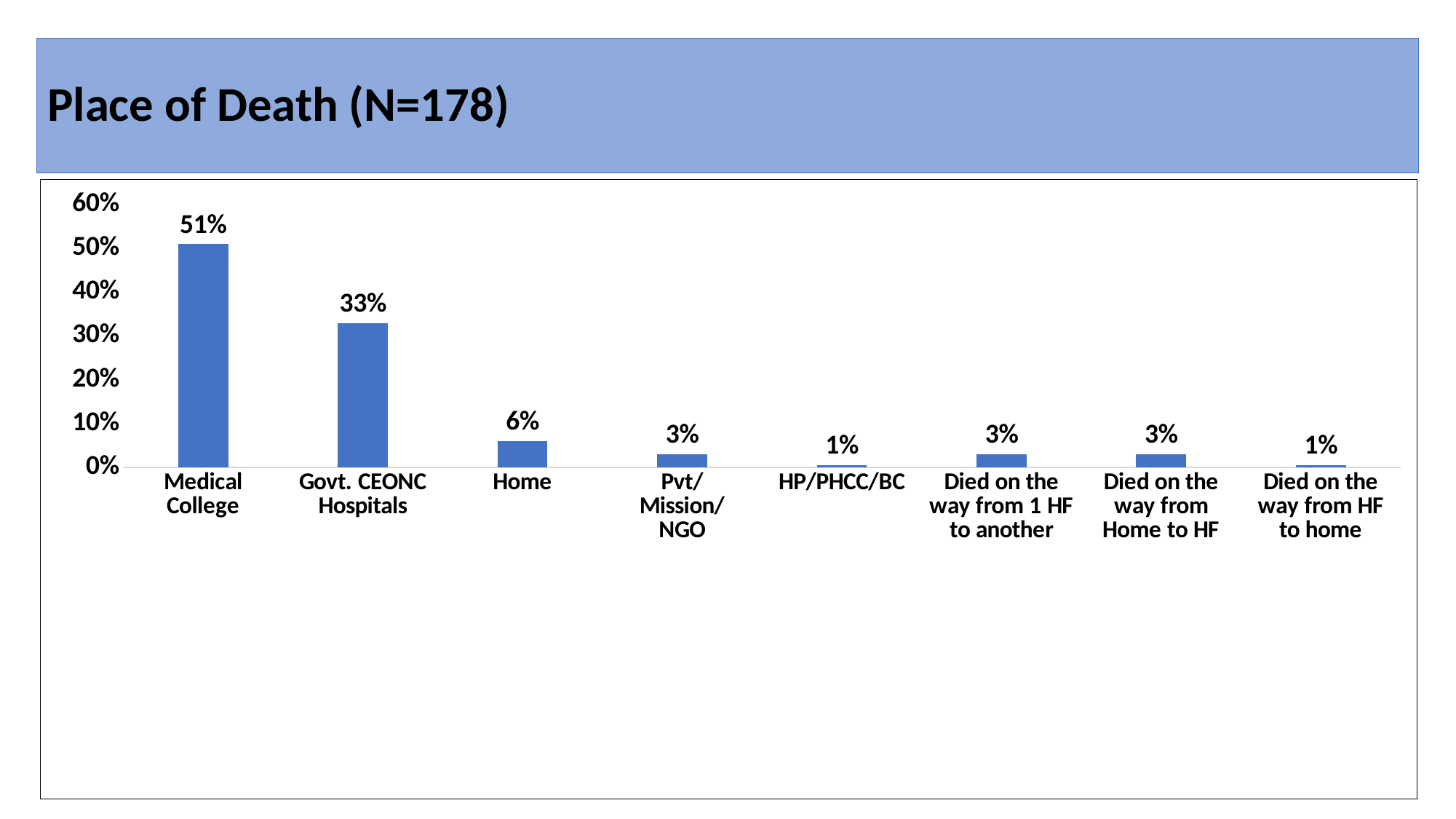
What is the difference between the Medical College and Govt. CEONC Hospitals percentages? 18% What is the title of the chart? Place of Death (N=178) Which is larger, the value for Home or the value for Pvt/Mission/NGO? Home Is the value for Medical College greater or less than 50%? greater What percentage of deaths occurred at Home? 6% Which place of death has the highest percentage? Medical College How many categories are shown on the x axis? 8 What is the value for HP/PHCC/BC? 1% What percentage of deaths occurred at a Medical College? 51% What is the value for Died on the way from Home to HF? 3% What is the value for Govt. CEONC Hospitals? 33% What kind of chart is shown on the slide? Bar chart